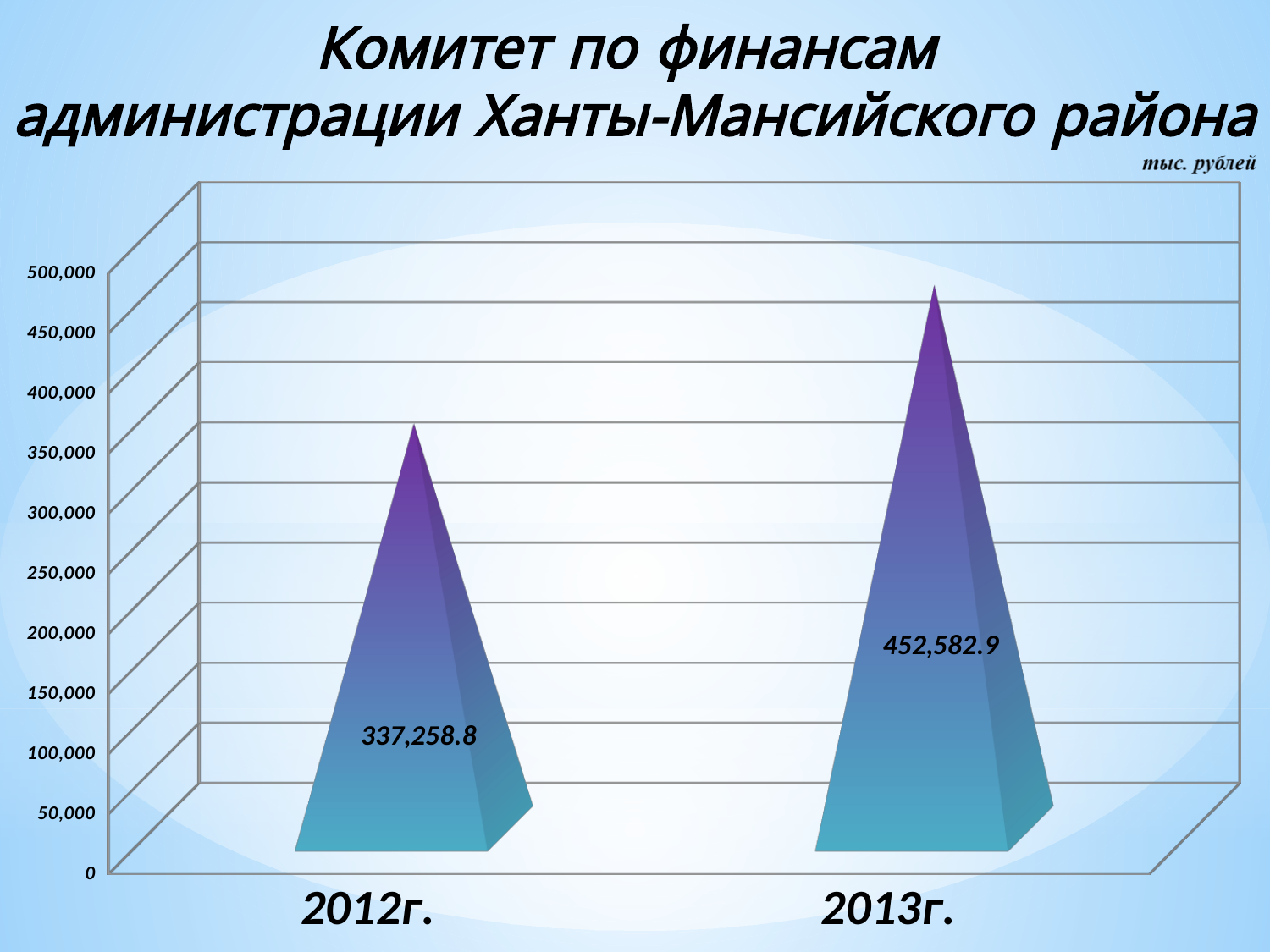
What kind of chart is shown on the slide? bar chart Which year has the lower value? 2012г. What is the value for 2012г.? 337,258.8 Is the value for 2012г. greater or less than 300,000? greater How many categories are shown on the x axis? 2 Is the value for 2012г. larger or smaller than the value for 2013г.? smaller Is the value for 2013г. greater or less than 500,000? less What is the difference between the values for 2013г. and 2012г.? 115,324.1 Which year has the higher value? 2013г. What unit is indicated above the chart? тыс. рублей Do the values rise or fall from 2012г. to 2013г.? rise What is the value for 2013г.? 452,582.9